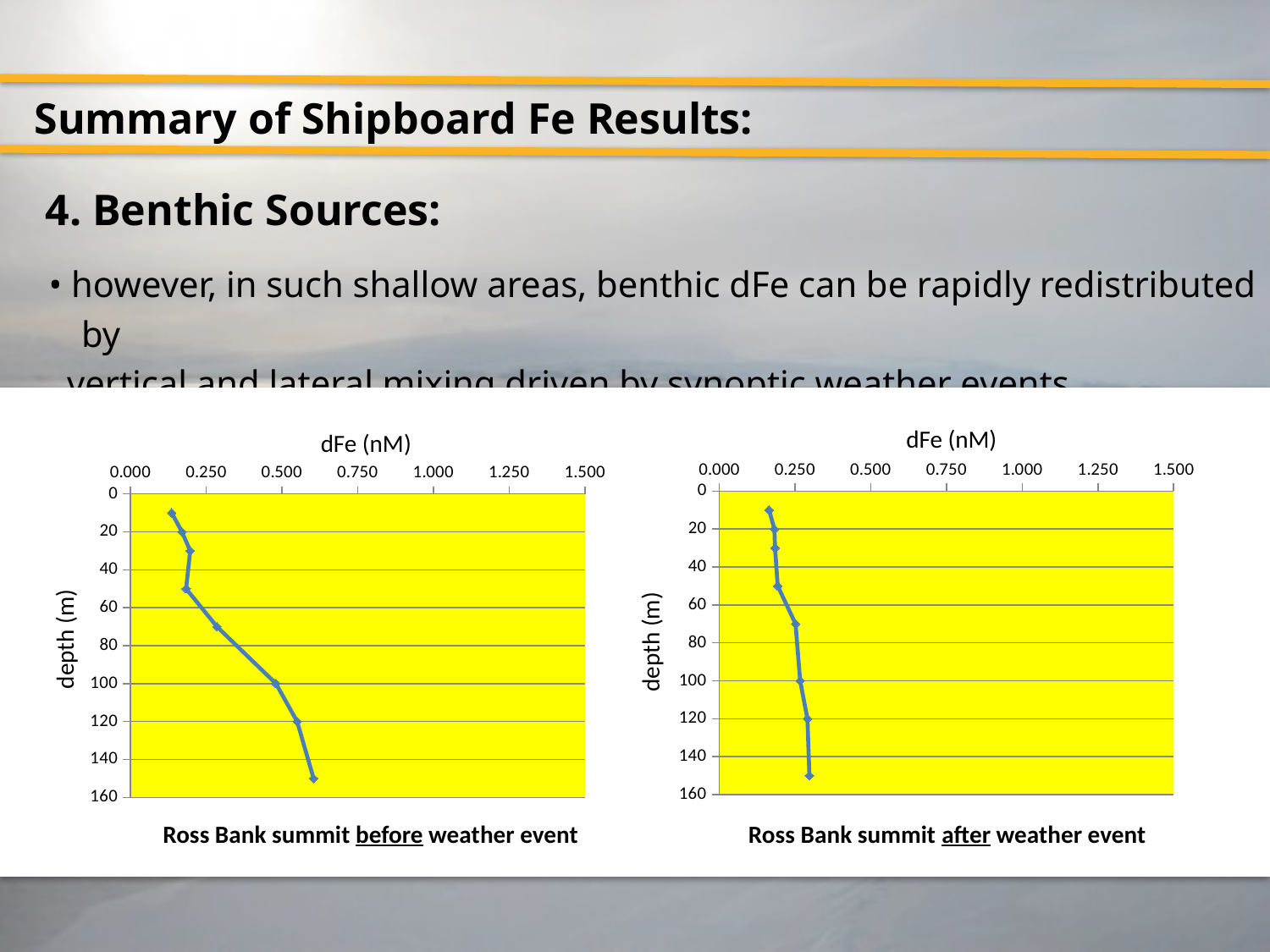
What is the label on the horizontal axis of the left chart? dFe (nM) In the 'Ross Bank summit before weather event' chart, does dFe increase or decrease as depth increases from 50 m to 150 m? increase In the 'Ross Bank summit before weather event' chart, at which depth is the dFe value highest? 150 How many data points are plotted in the 'Ross Bank summit after weather event' chart? 8 In the 'Ross Bank summit before weather event' chart, is the dFe value at 10 m depth greater or less than 0.250 nM? less Which chart shows the larger dFe value at 150 m depth, 'before weather event' or 'after weather event'? before weather event What is the label on the vertical axis of the right chart? depth (m) What kind of chart is the 'Ross Bank summit before weather event' chart? line chart In the 'Ross Bank summit before weather event' chart, at which depth is the dFe value lowest? 10 In the 'Ross Bank summit after weather event' chart, is the dFe value at 150 m depth greater or less than 0.500 nM? less In the 'Ross Bank summit before weather event' chart, is the dFe value at 150 m depth greater or less than 0.500 nM? greater